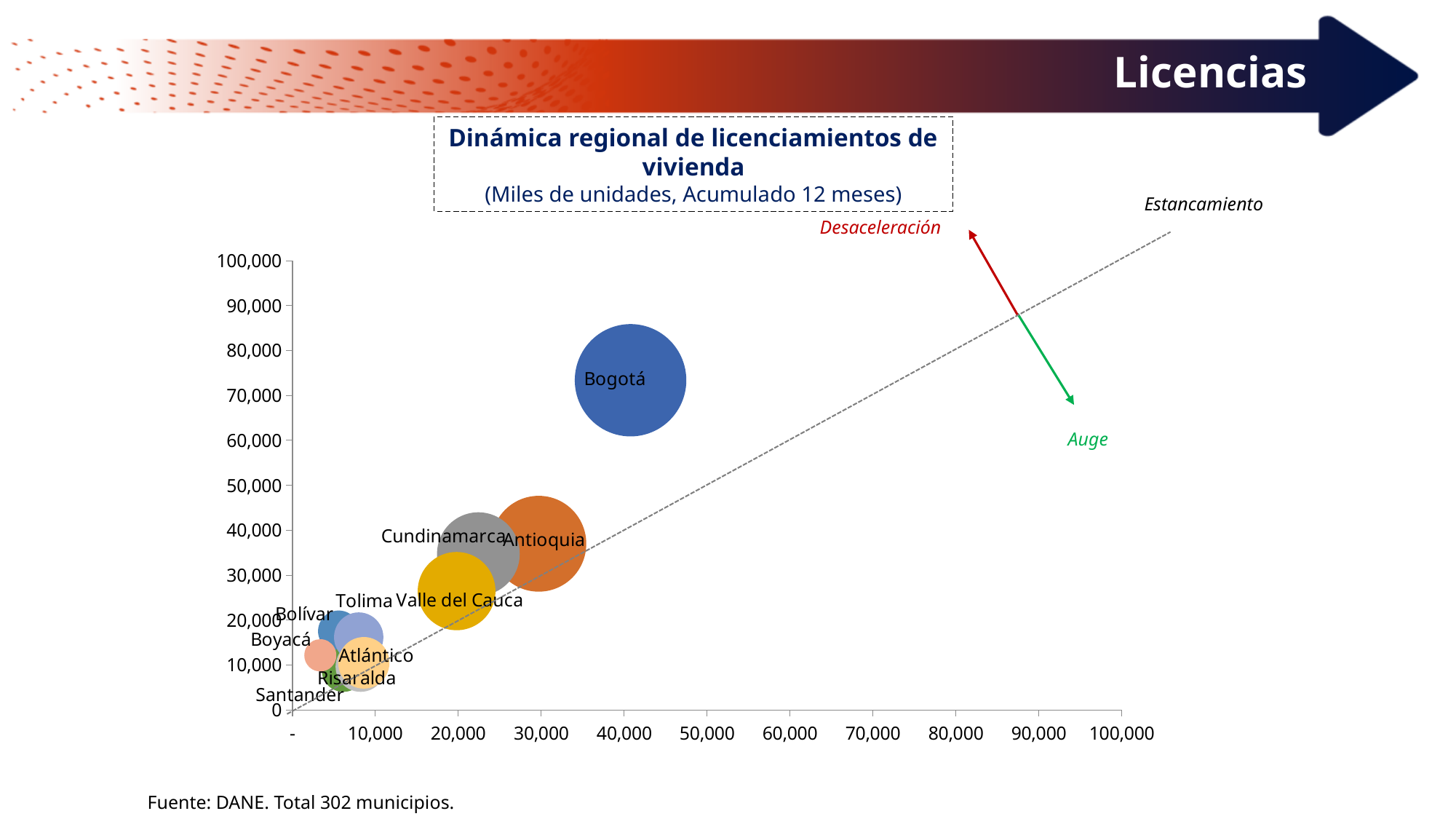
What is the source cited below the chart? DANE. Total 302 municipios. Is the horizontal-axis value for Valle del Cauca greater or less than 30,000? less What kind of chart is shown on the slide? Bubble chart Is the horizontal-axis value for Bogotá greater or less than 30,000? greater What is the title of the chart? Dinámica regional de licenciamientos de vivienda Which has the higher vertical-axis value, Bogotá or Antioquia? Bogotá How many labelled bubbles (regions) are plotted on the chart? 10 Is the vertical-axis value for Bogotá greater or less than 60,000? greater Which region has the highest value on the vertical axis? Bogotá What is the maximum value shown on the vertical axis? 100,000 Which region is represented by the largest bubble? Bogotá